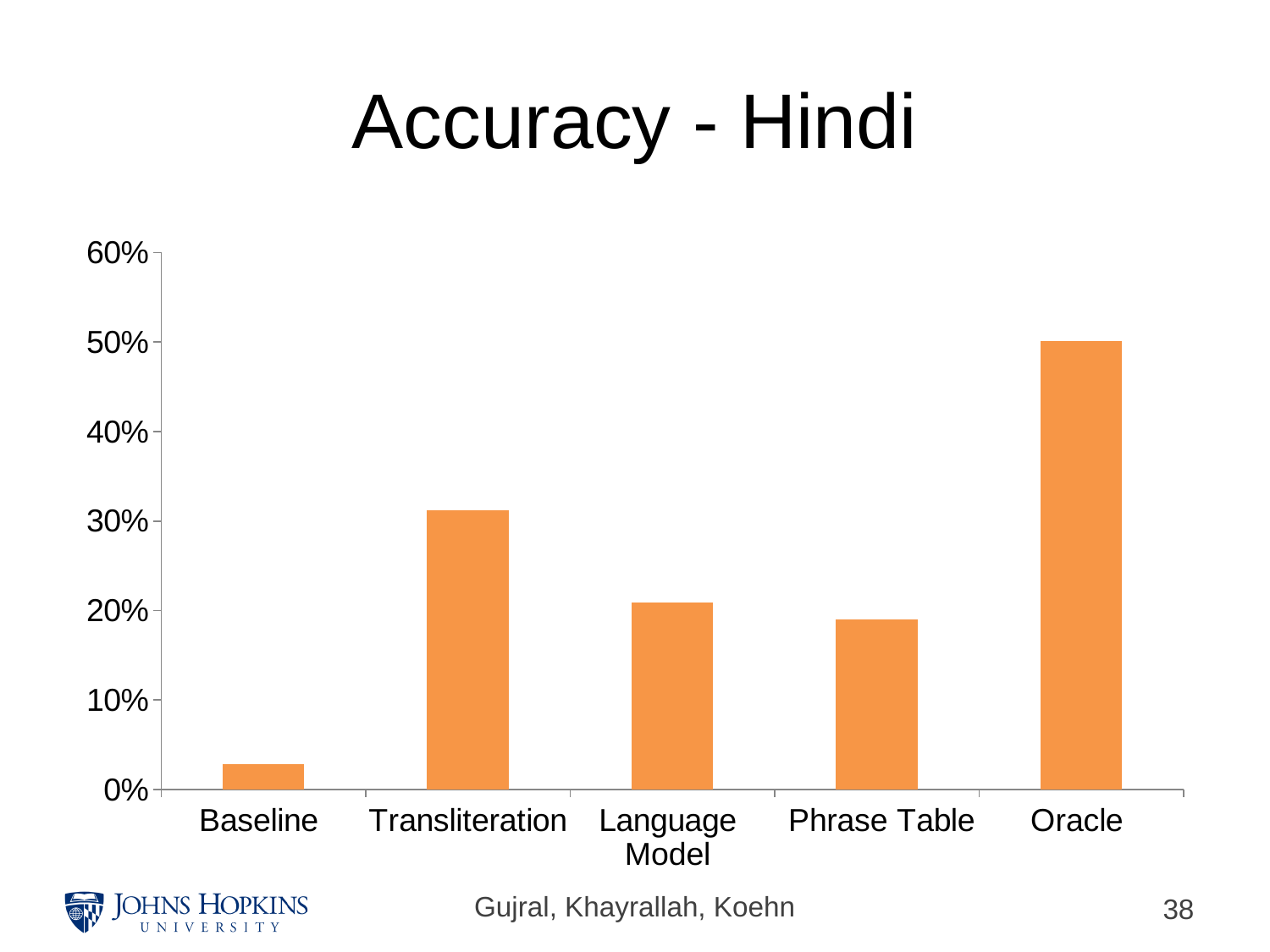
Is the value for Oracle greater or less than 40%? greater What kind of chart is shown on the slide? bar chart Which category has the highest accuracy? Oracle Which category has the lowest accuracy? Baseline Is the value for Phrase Table greater or less than 20%? less Is the value for Baseline greater or less than 10%? less Which is larger, the value for Transliteration or the value for Language Model? Transliteration How many categories are shown on the x axis? 5 What is the title of the chart? Accuracy - Hindi Which is larger, the value for Language Model or the value for Phrase Table? Language Model